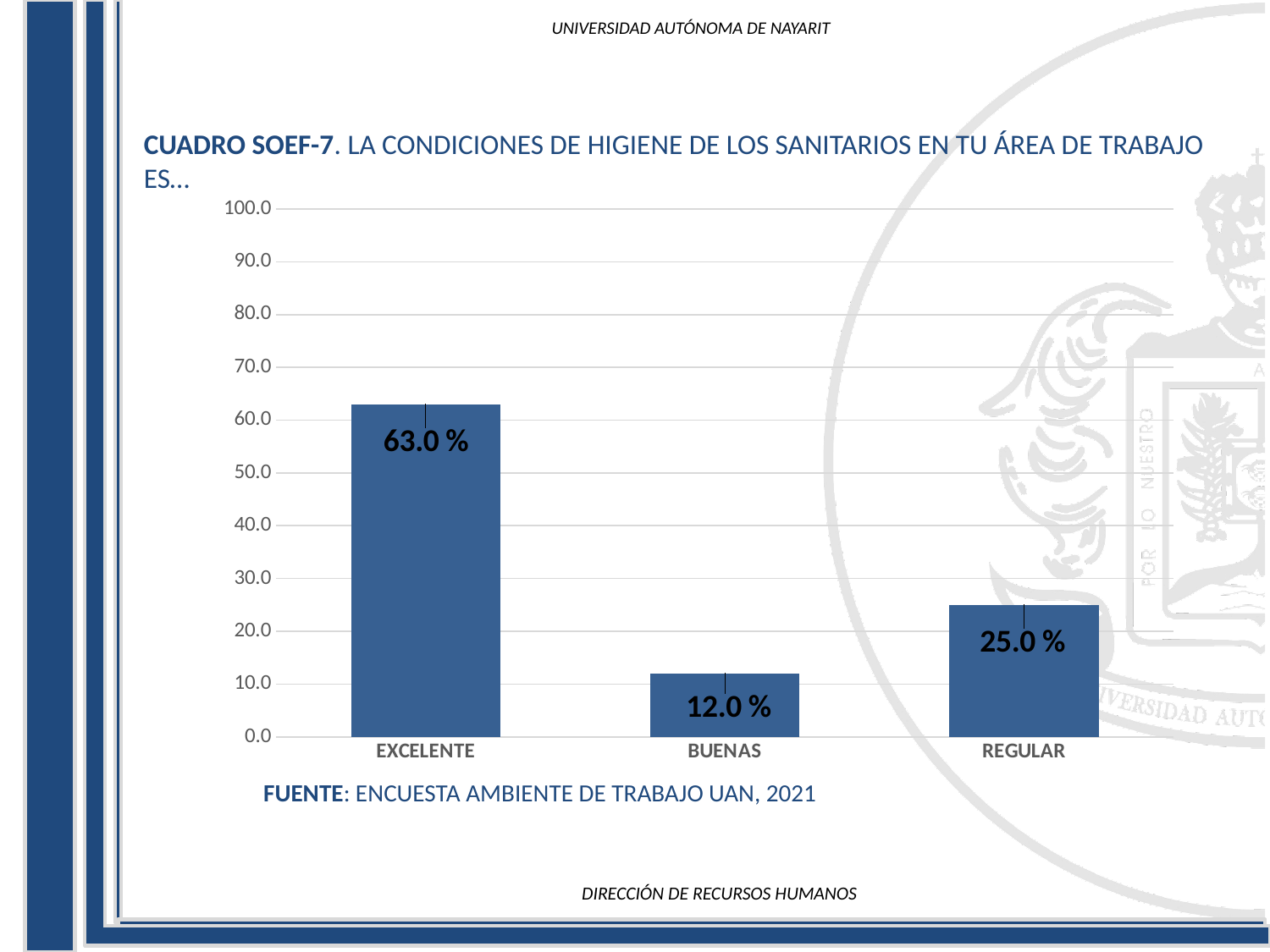
Which category has the lowest value? BUENAS What is the value for EXCELENTE? 63.0 % Is the value for EXCELENTE greater or less than 50.0? greater What source is cited below the chart? ENCUESTA AMBIENTE DE TRABAJO UAN, 2021 What is the value for BUENAS? 12.0 % What is the difference between the values for EXCELENTE and REGULAR? 38.0 % Which is larger, the value for REGULAR or the value for BUENAS? REGULAR How many categories are shown on the x axis? 3 What is the difference between the values for REGULAR and BUENAS? 13.0 % What kind of chart is shown on the slide? bar chart What is the value for REGULAR? 25.0 % Which category has the highest value? EXCELENTE